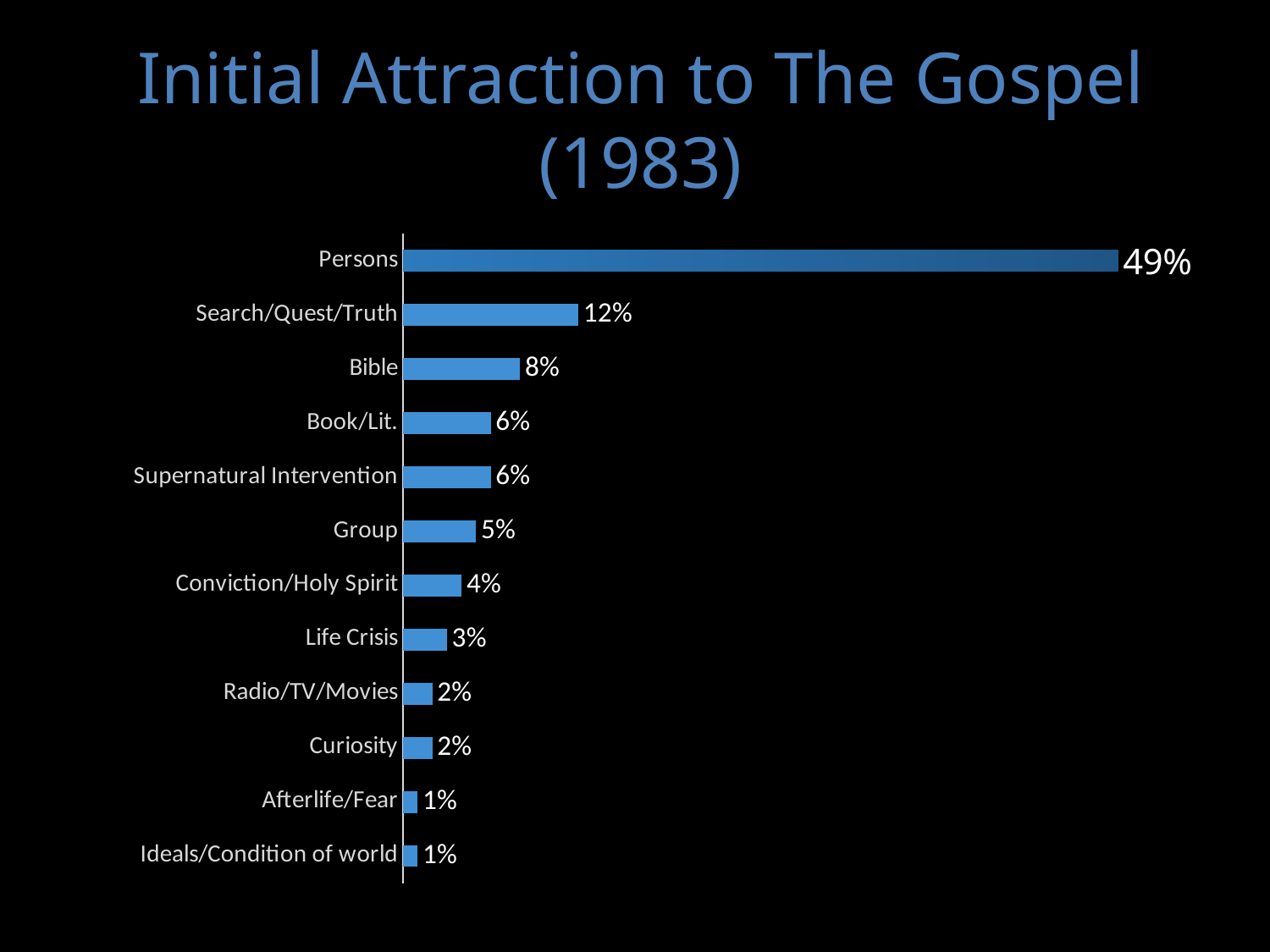
What is the difference between the values for Persons and Search/Quest/Truth? 37% What is the value for Life Crisis? 3% How many categories are shown in the chart? 12 What is the title of the slide? Initial Attraction to The Gospel (1983) What kind of chart is shown on the slide? Bar chart What is the value for Search/Quest/Truth? 12% Which category has the highest value? Persons What is the difference between the values for Bible and Group? 3% Which is larger, the value for Book/Lit. or the value for Life Crisis? Book/Lit. What is the value for Persons? 49% What is the value for Conviction/Holy Spirit? 4% What is the value for Bible? 8%